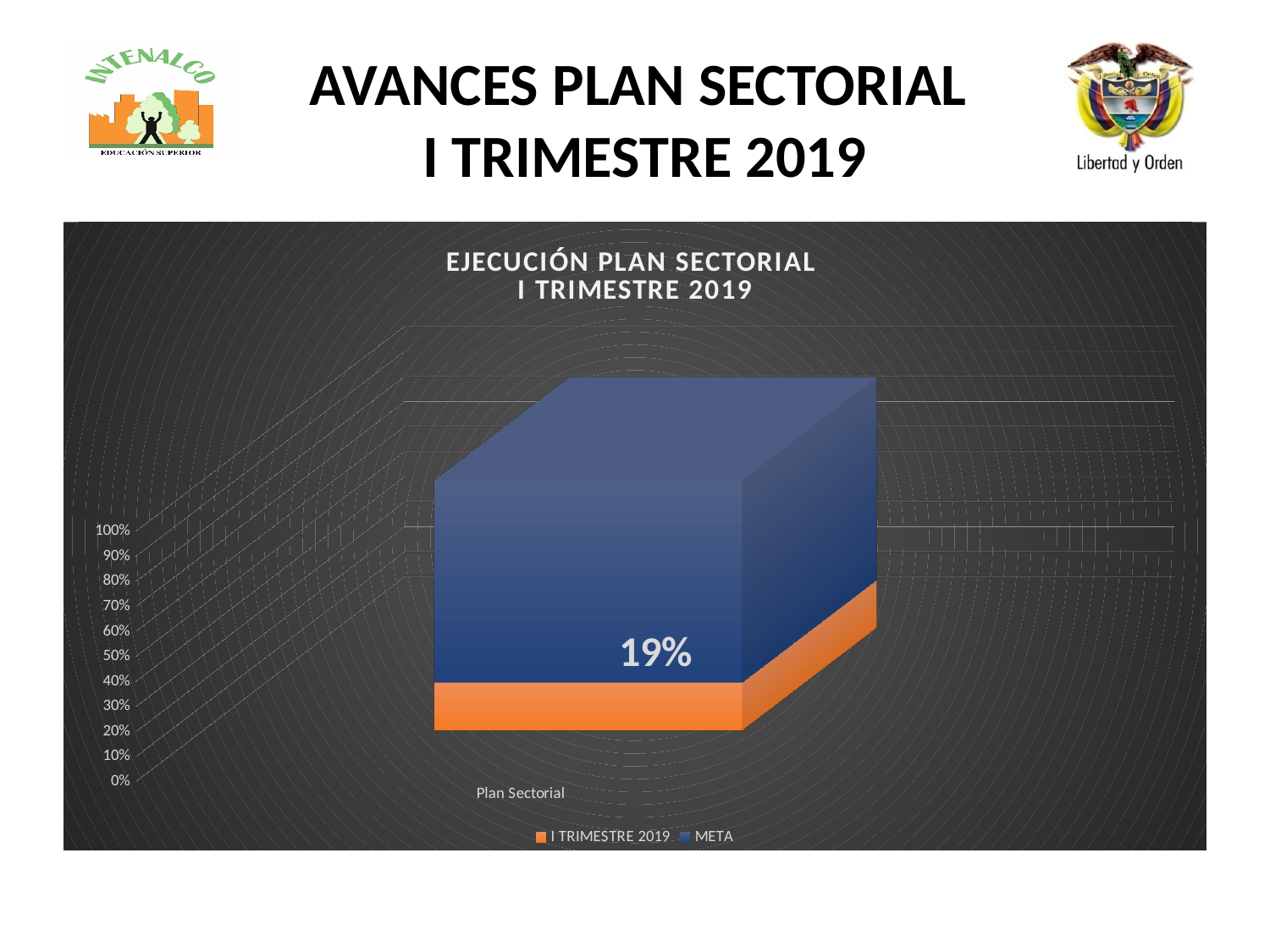
What is the title of the chart? EJECUCIÓN PLAN SECTORIAL I TRIMESTRE 2019 How many series does the legend list? 2 Which series has the larger segment in the bar, I TRIMESTRE 2019 or META? META How many categories are shown on the x axis? 1 Which series are listed in the legend? I TRIMESTRE 2019 and META Is the value for I TRIMESTRE 2019 greater or less than 50%? less What value is printed on the bar for I TRIMESTRE 2019? 19% What is the name of the category shown on the x axis? Plan Sectorial What kind of chart is shown on the slide? bar chart What is the highest value shown on the y axis? 100%